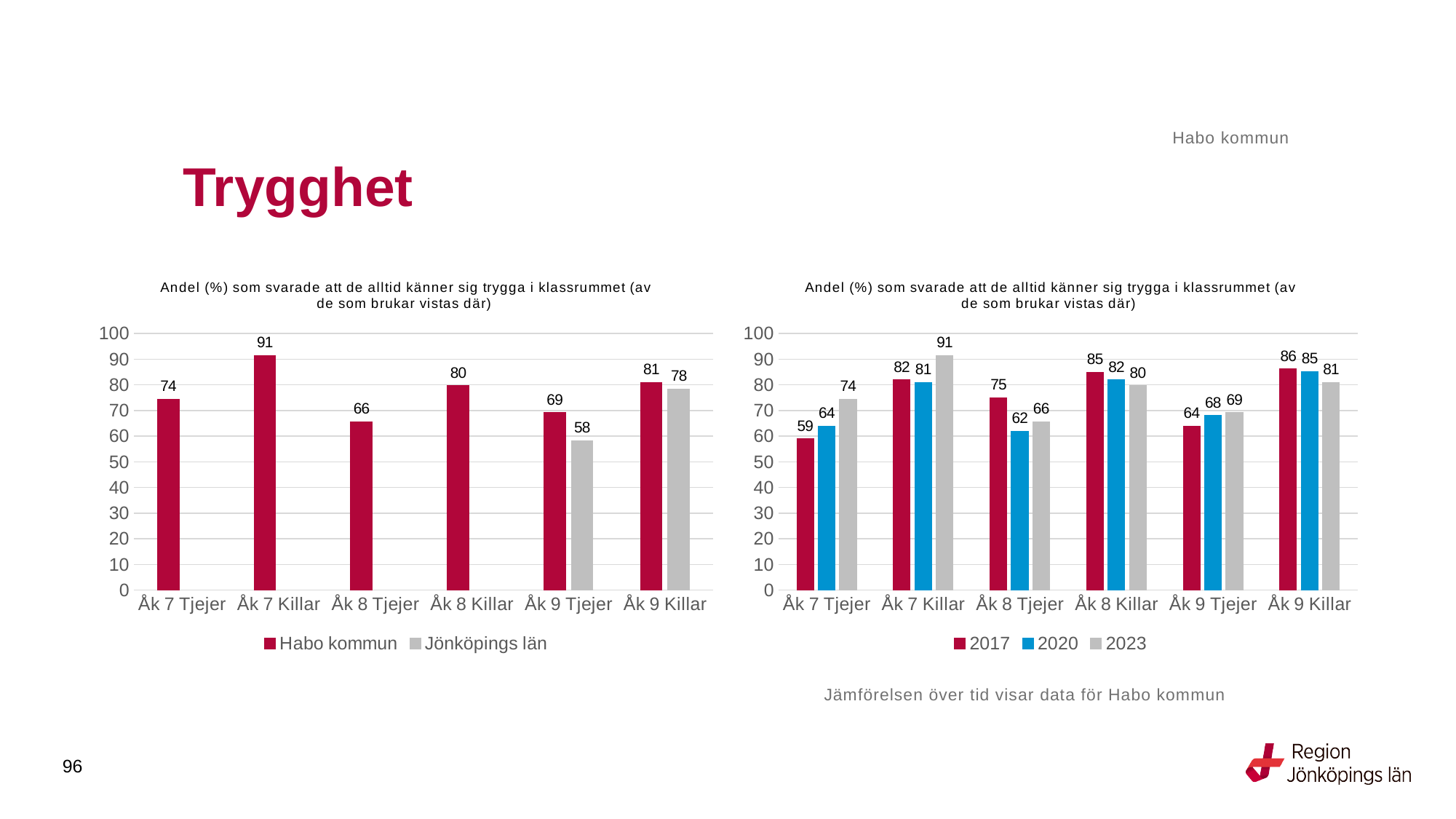
In the right chart, what is the difference between the 2023 and 2017 values for Åk 7 Tjejer? 15 In the left chart, what is the value for Jönköpings län for Åk 9 Tjejer? 58 In the right chart, what is the 2020 value for Åk 8 Tjejer? 62 In the left chart, which category has the lowest Habo kommun value? Åk 8 Tjejer In the right chart, how many categories are shown on the x axis? 6 What type of chart is the right chart? Bar chart In the left chart, what is the value for Habo kommun for Åk 7 Killar? 91 In the right chart, which is larger for Åk 9 Tjejer: the 2017 value or the 2023 value? 2023 In the right chart, what is the 2017 value for Åk 7 Tjejer? 59 In the right chart, which category has the highest 2023 value? Åk 7 Killar In the left chart, how many series does the legend list? 2 In the left chart, what is the difference between Habo kommun and Jönköpings län for Åk 9 Tjejer? 11